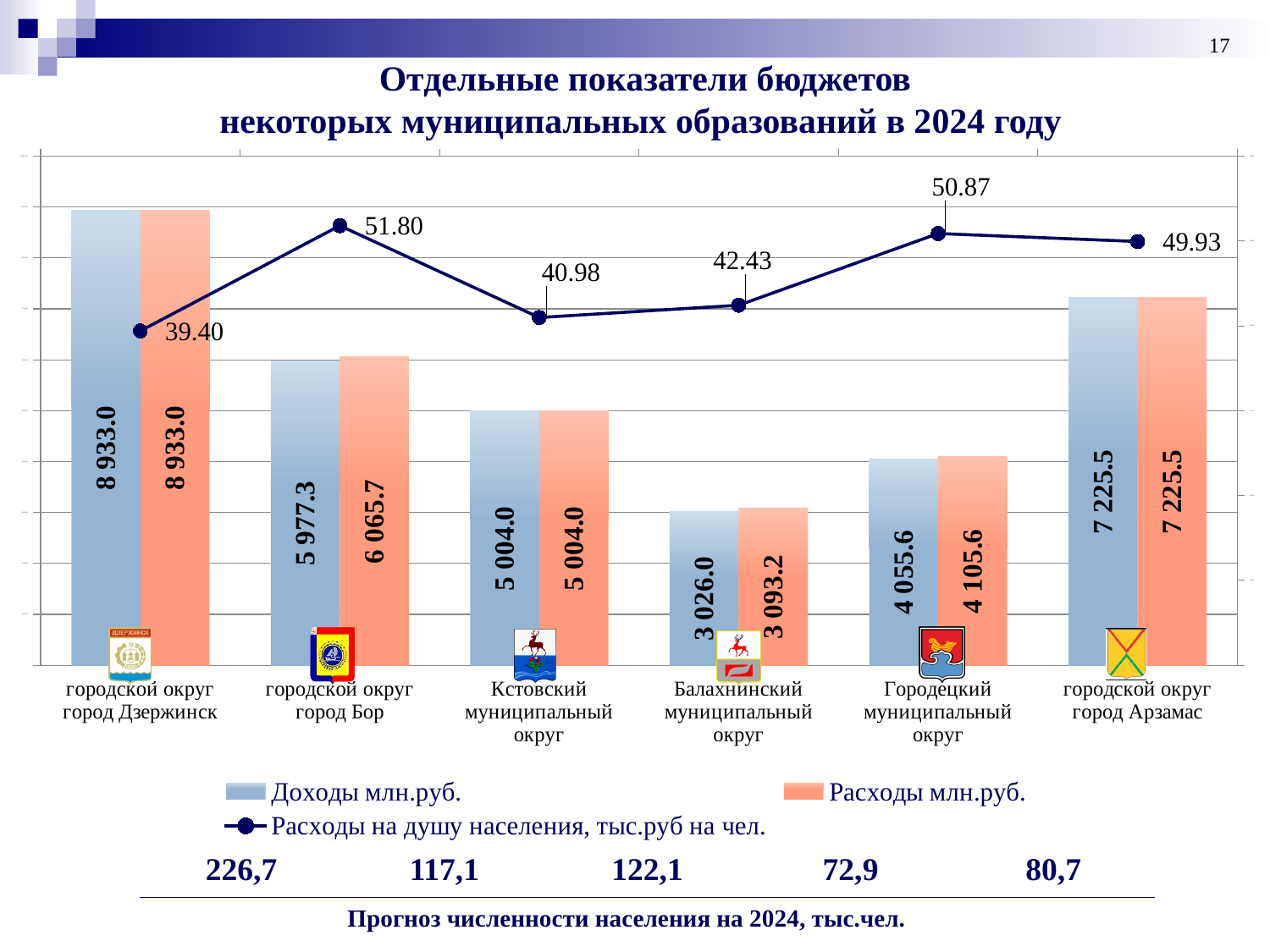
Which municipality has the lowest Расходы млн.руб.? Балахнинский муниципальный округ How many series does the legend list? 3 What is the value of Расходы млн.руб. for Балахнинский муниципальный округ? 3 093.2 What is the value of Доходы млн.руб. for городской округ город Бор? 5 977.3 What kind of chart is shown on the slide? Combined bar and line chart Which municipality has the lowest Расходы на душу населения? городской округ город Дзержинск Which has higher Доходы млн.руб.: Кстовский муниципальный округ or Городецкий муниципальный округ? Кстовский муниципальный округ How many municipalities are shown on the chart? 6 By how much do Расходы млн.руб. exceed Доходы млн.руб. for городской округ город Бор? 88.4 What is the value of Расходы на душу населения for Городецкий муниципальный округ? 50.87 Which municipality has the highest Расходы на душу населения? городской округ город Бор Which municipality has the highest Доходы млн.руб.? городской округ город Дзержинск